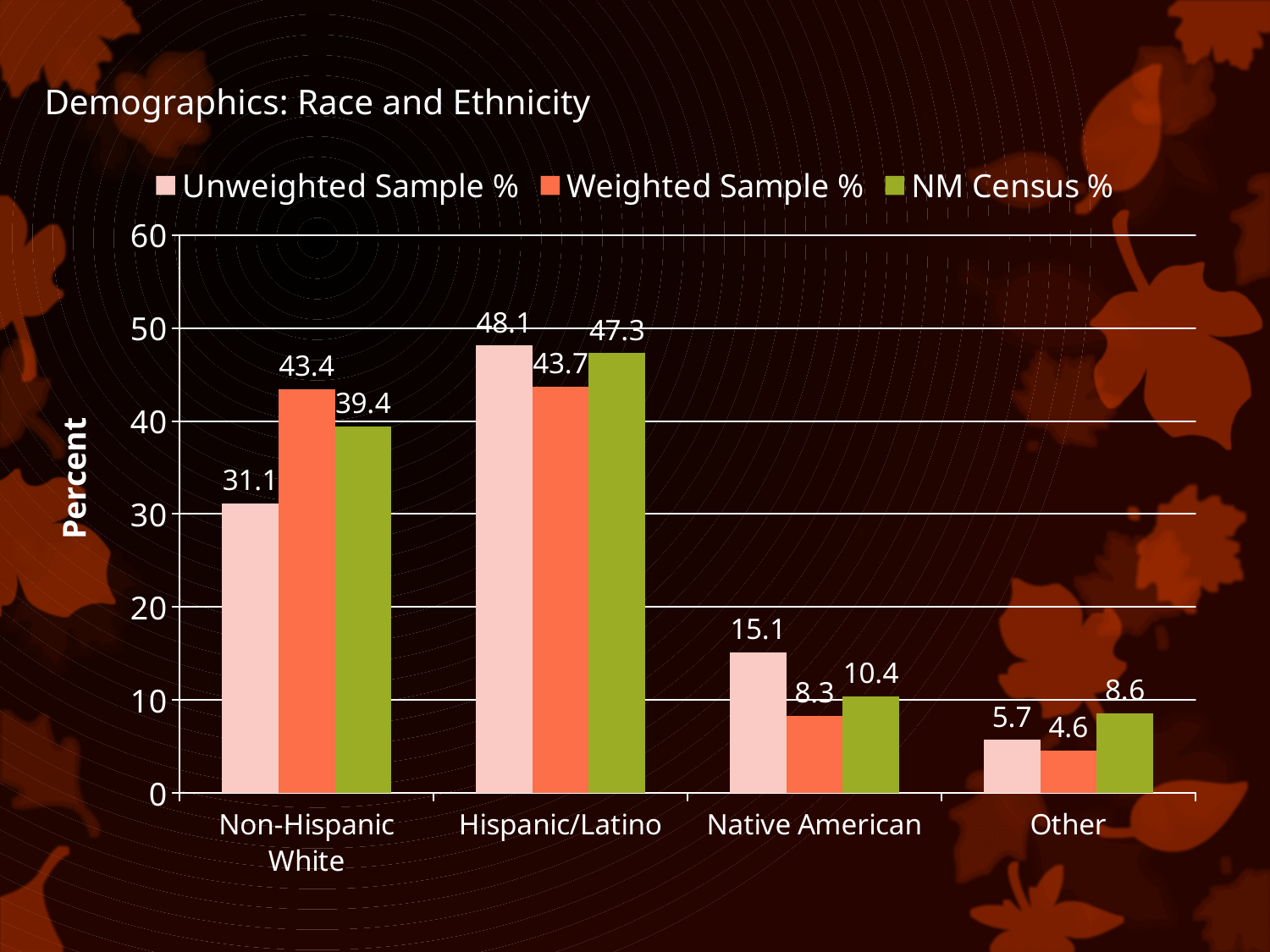
What is the difference between the Weighted Sample % and Unweighted Sample % values for Non-Hispanic White? 12.3 Which is larger for Native American: the Unweighted Sample % or the NM Census %? Unweighted Sample % How many categories are shown on the x axis? 4 What is the NM Census % value for Hispanic/Latino? 47.3 What is the Weighted Sample % value for Native American? 8.3 What is the Unweighted Sample % value for Non-Hispanic White? 31.1 Which category has the highest Unweighted Sample % value? Hispanic/Latino Is the Weighted Sample % value for Hispanic/Latino greater or less than 40? greater How many series does the legend list? 3 What is the label of the y axis? Percent Which category has the lowest NM Census % value? Other What kind of chart is shown on the slide? bar chart